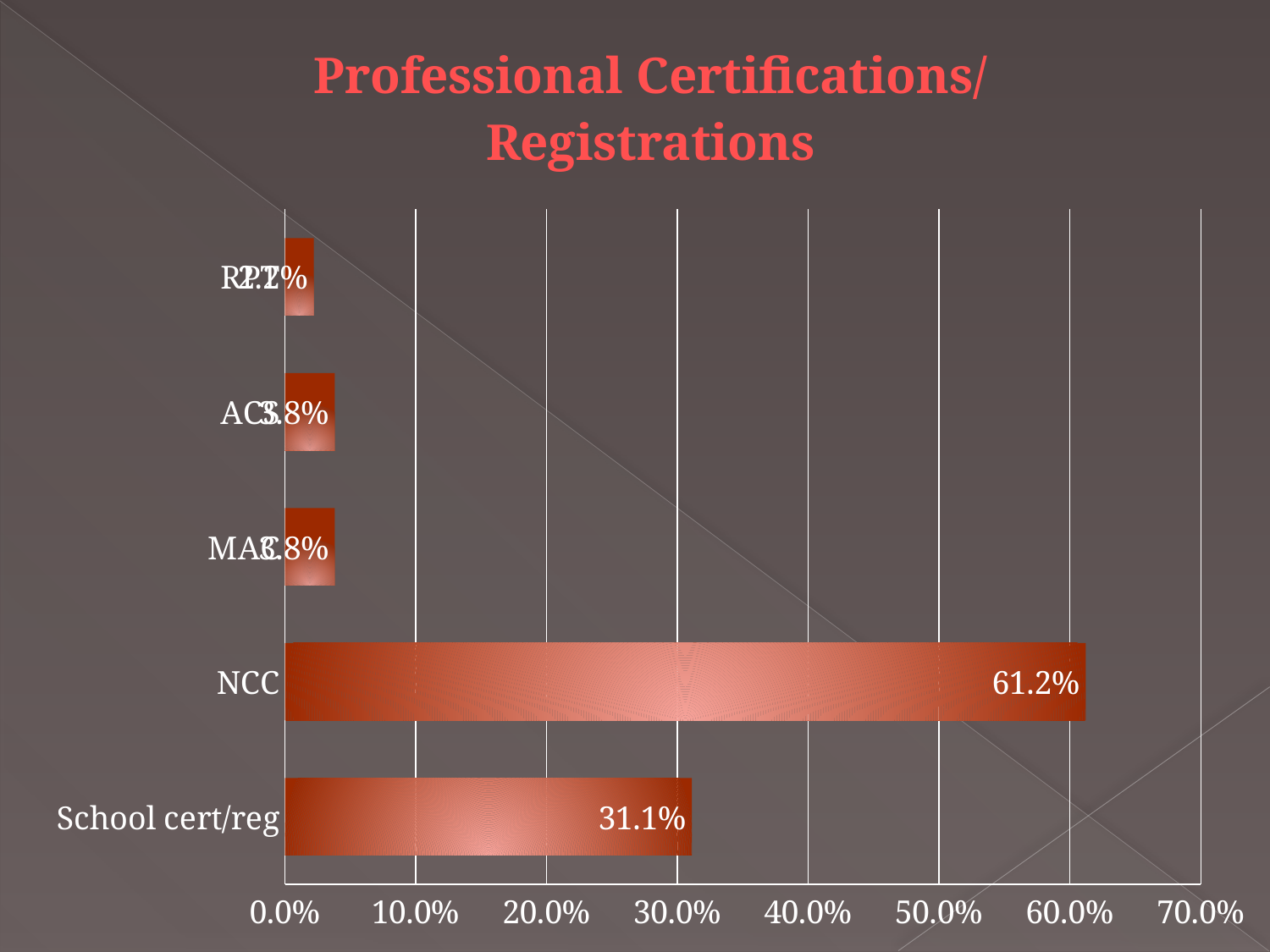
How many categories (bars) are shown in the chart? 5 What kind of chart is shown on the slide? bar chart What is the difference between the values for NCC and School cert/reg? 30.1% What is the value for School cert/reg? 31.1% What is the title of the chart? Professional Certifications/Registrations Which is larger, the value for NCC or the value for School cert/reg? NCC Is the value for School cert/reg greater or less than 40.0%? less What is the highest value shown on the x axis? 70.0% Is the value for NCC greater or less than 50.0%? greater What is the value for NCC? 61.2% Which category has the highest value? NCC